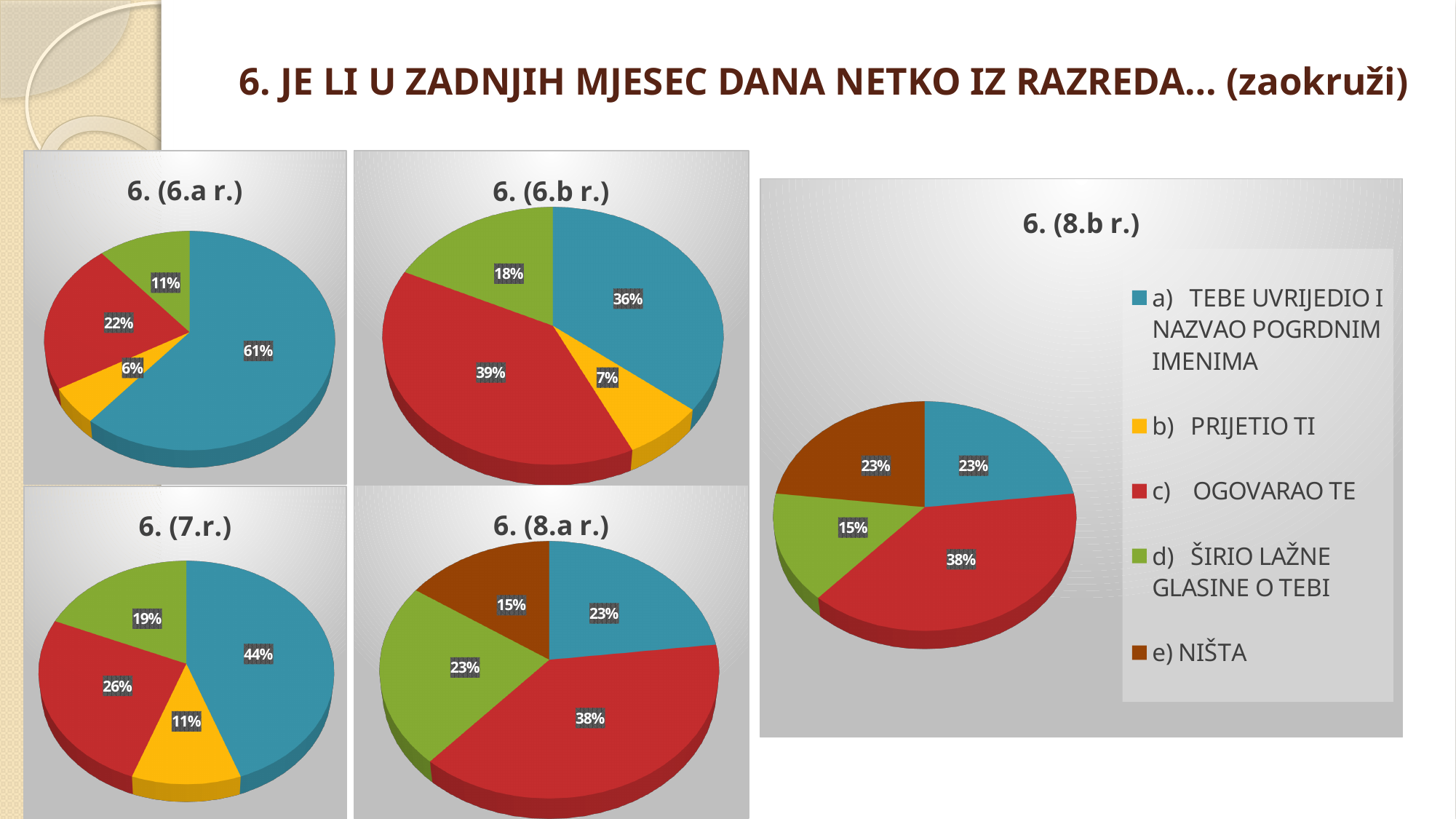
In the "6. (8.b r.)" pie chart, which is larger: "c) OGOVARAO TE" or "d) ŠIRIO LAŽNE GLASINE O TEBI"? c) OGOVARAO TE In the "6. (8.b r.)" pie chart, what is the share for "e) NIŠTA"? 23% In the "6. (6.a r.)" pie chart, what percentage does the blue slice show? 61% In the "6. (6.b r.)" pie chart, what percentage does the red slice show? 39% How many slices does the "6. (8.a r.)" pie chart have? 4 In the "6. (6.a r.)" pie chart, which slice is the largest? the blue slice (61%) In the "6. (8.a r.)" pie chart, what percentage does the brown slice show? 15% In the "6. (6.b r.)" pie chart, which slice is the smallest? the yellow slice (7%) In the "6. (7.r.)" pie chart, what is the difference between the blue slice and the red slice? 18 percentage points How many entries does the legend of the "6. (8.b r.)" chart list? 5 In the "6. (7.r.)" pie chart, what percentage does the yellow slice show? 11% What type of chart is used for "6. (6.b r.)"? pie chart